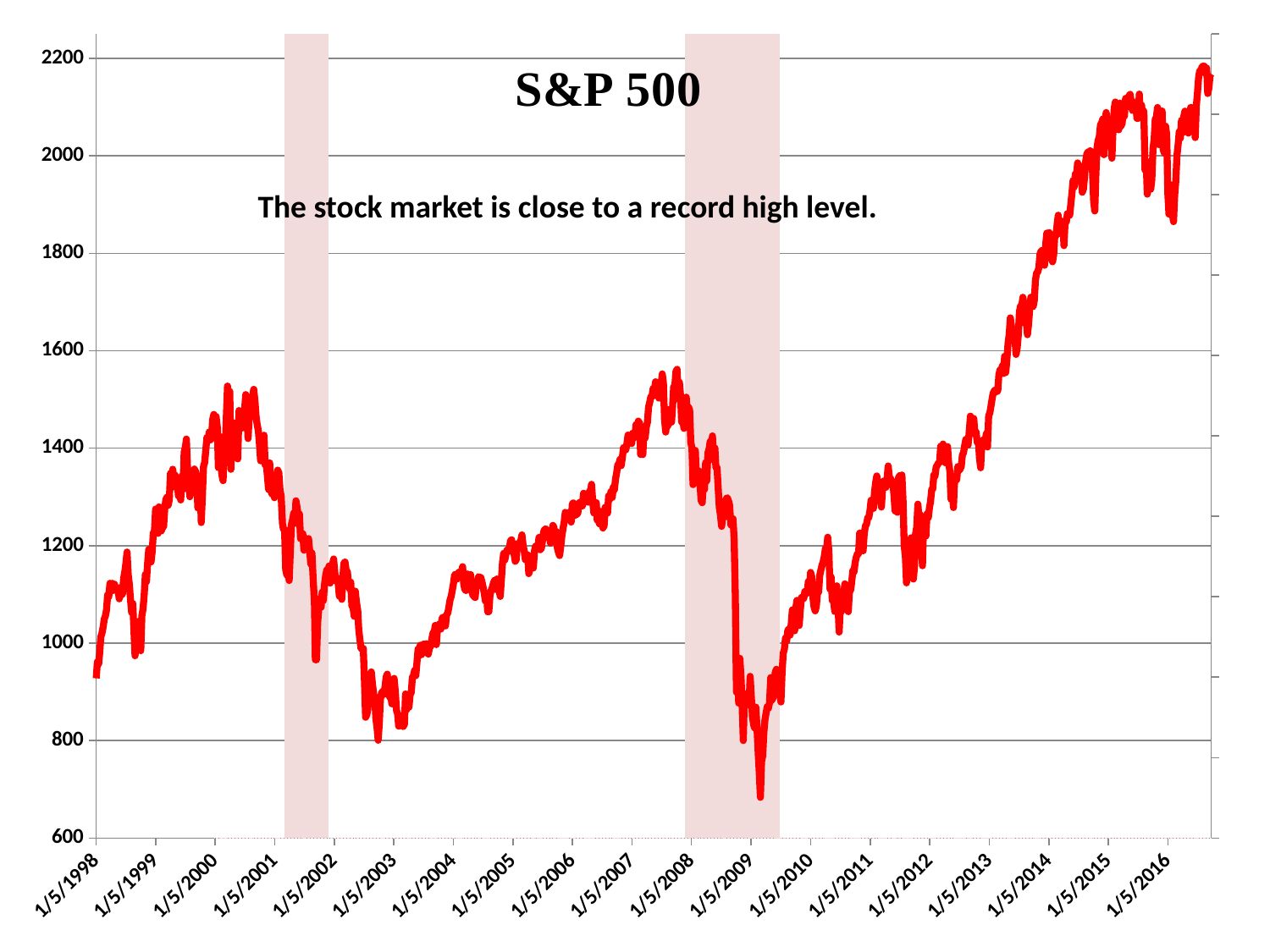
What message is written on the chart about the stock market? The stock market is close to a record high level. Is the S&P 500 value at 1/5/2007 greater or less than 1200? greater Does the S&P 500 line rise or fall between 1/5/2000 and 1/5/2003? fall Is the S&P 500 value at 1/5/1998 greater or less than 1000? less Is the lowest point of the S&P 500 line greater or less than 800? less Does the S&P 500 line rise or fall between 1/5/2009 and 1/5/2016? rise What kind of chart is shown on the slide? line chart What is the title of the chart? S&P 500 Which is larger, the S&P 500 value at 1/5/2016 or at 1/5/2008? 1/5/2016